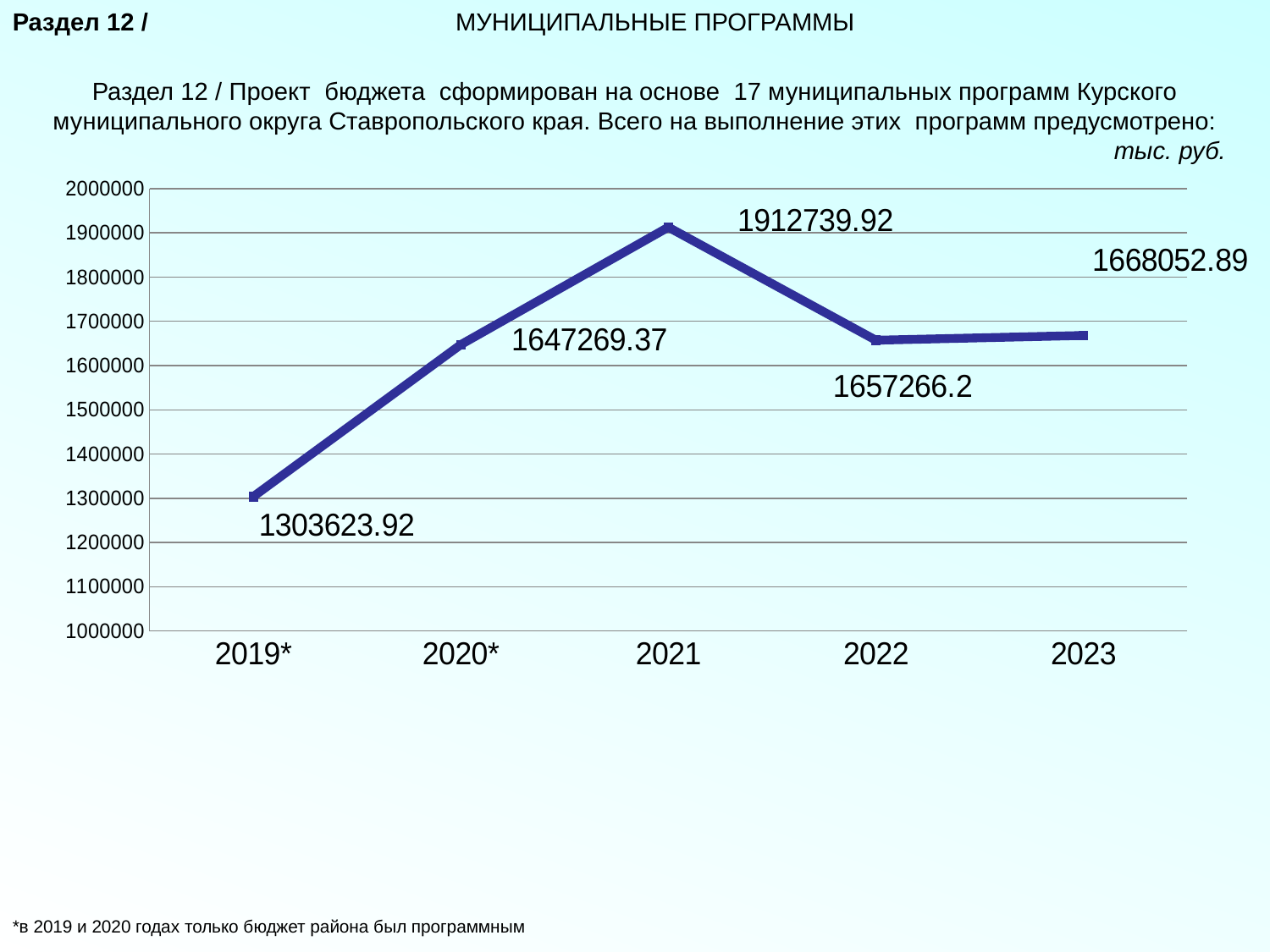
What is the value for 2021? 1912739.92 Is the value for 2019* greater or less than 1400000? less What is the value for 2023? 1668052.89 What is the value for 2022? 1657266.2 What is the value for 2019*? 1303623.92 Which is larger, the value for 2020* or the value for 2021? 2021 What is the difference between the values for 2023 and 2022? 10786.69 What is the difference between the values for 2021 and 2019*? 609116 What kind of chart is shown on the slide? line chart How many years are plotted on the chart? 5 Which year has the lowest value? 2019* Which year has the highest value? 2021